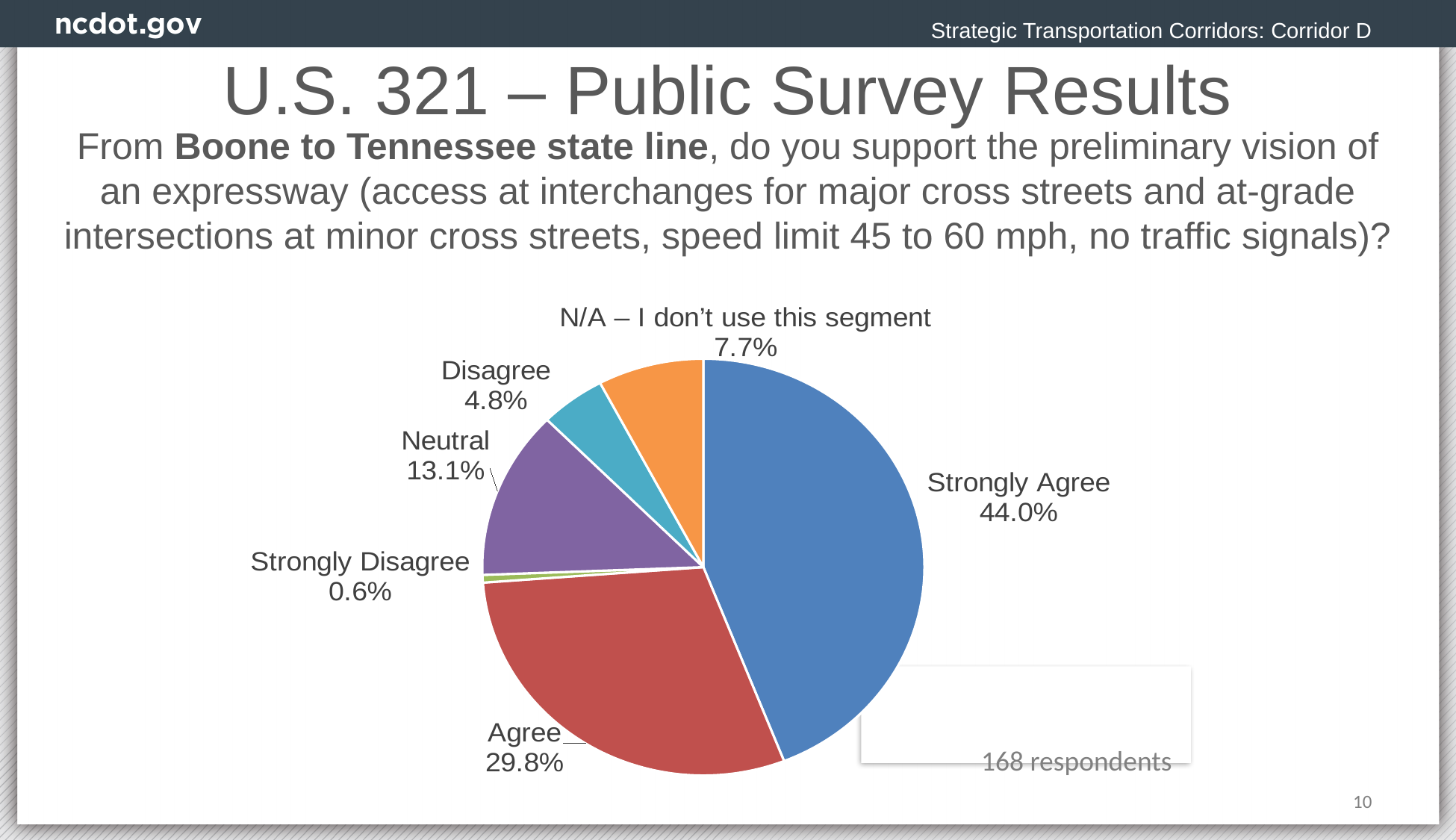
What share of respondents answered N/A – I don't use this segment? 7.7% What kind of chart is shown on the slide? pie chart Which response category has the largest slice of the pie? Strongly Agree Which response category has the smallest slice of the pie? Strongly Disagree What share of respondents answered Agree? 29.8% How many slices does the pie chart have? 6 What share of respondents answered Strongly Agree? 44.0% What share of respondents answered Neutral? 13.1% What is the difference in percentage points between Strongly Agree and Agree? 14.2 What share of respondents answered Strongly Disagree? 0.6% What share of respondents answered Disagree? 4.8% How many respondents does the chart note say took the survey? 168 respondents